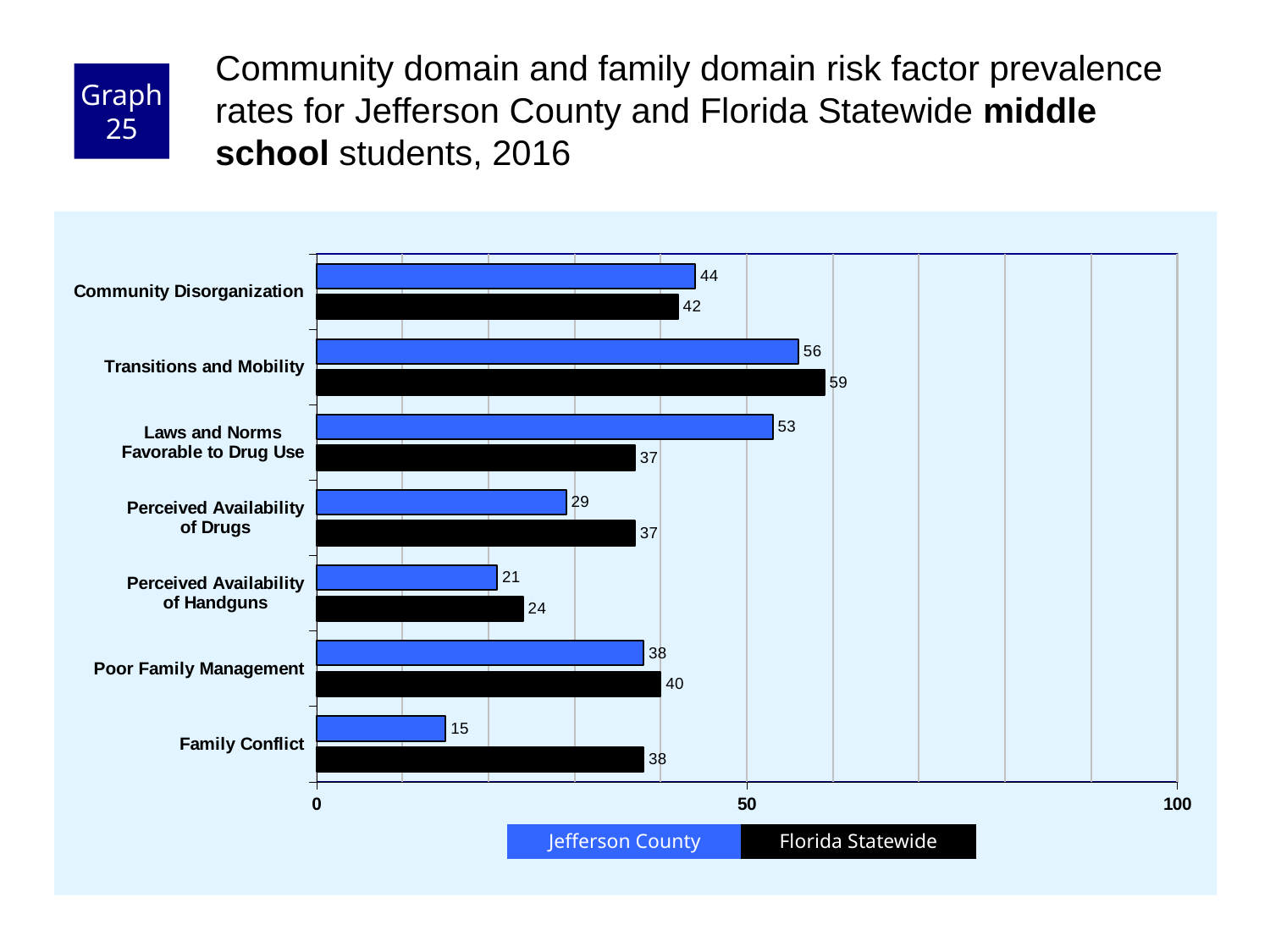
What is the difference between the Florida Statewide and Jefferson County values for Family Conflict? 23 Which risk factor has the lowest Jefferson County value? Family Conflict What is the Florida Statewide value for Family Conflict? 38 How many risk factor categories are shown on the chart? 7 What is the Jefferson County value for Transitions and Mobility? 56 What is the Jefferson County value for Perceived Availability of Handguns? 21 How many series does the legend list? 2 Is the Florida Statewide value for Transitions and Mobility greater or less than 50? greater Which risk factor has the highest Florida Statewide value? Transitions and Mobility What kind of chart is shown on the slide? bar chart What is the difference between the Jefferson County and Florida Statewide values for Laws and Norms Favorable to Drug Use? 16 Which is larger for Perceived Availability of Drugs: the Jefferson County value or the Florida Statewide value? Florida Statewide